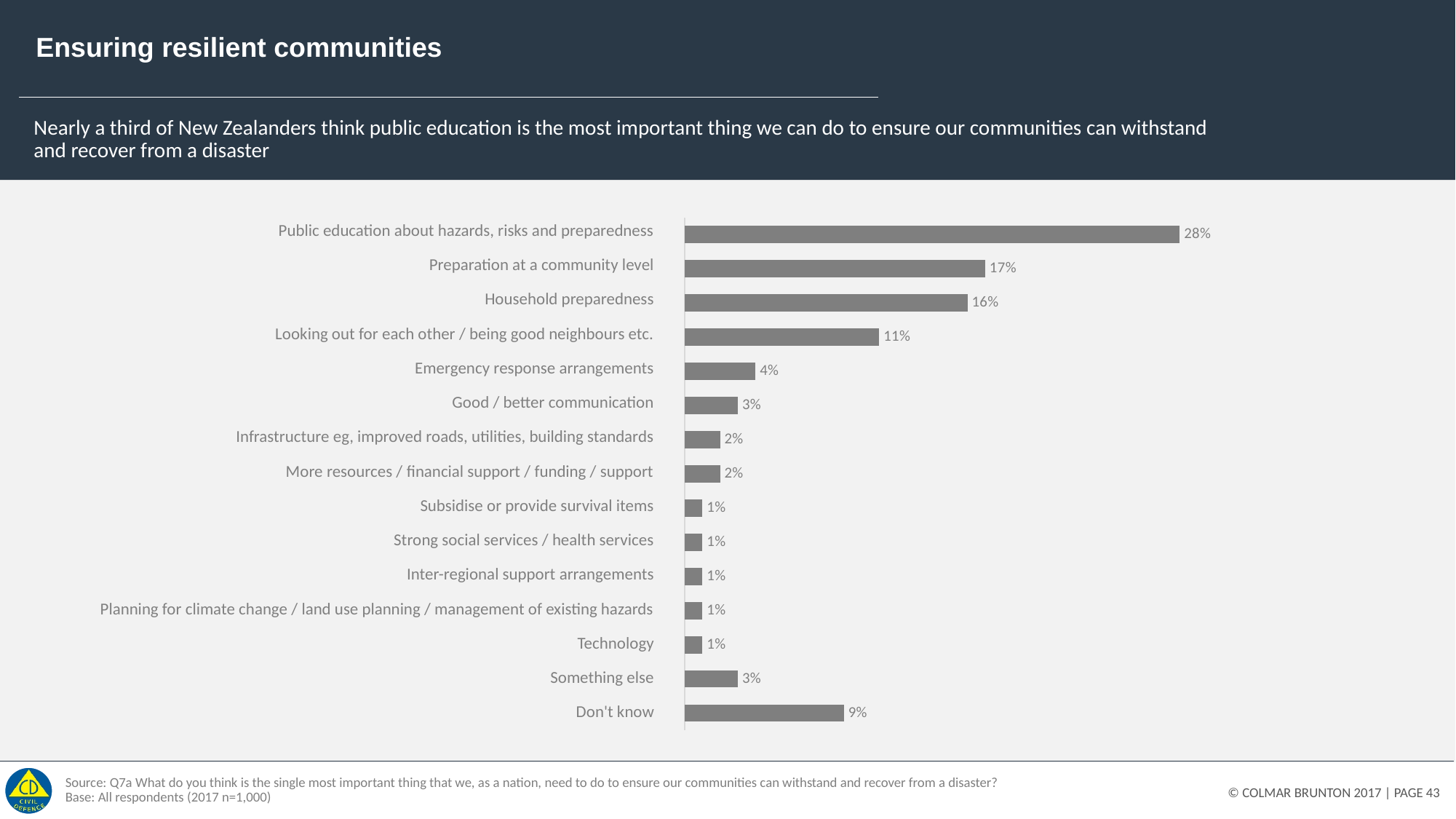
What kind of chart is shown on the slide? Bar chart What is the value for Emergency response arrangements? 4% Which is larger: Good / better communication or Looking out for each other / being good neighbours etc.? Looking out for each other / being good neighbours etc. What is the difference between Preparation at a community level and Household preparedness? 1% What is the value for Something else? 3% What percentage of respondents answered Don't know? 9% What is the value for Household preparedness? 16% What percentage of respondents chose public education about hazards, risks and preparedness? 28% How many categories are shown in the chart? 15 Which category has the highest value? Public education about hazards, risks and preparedness What is the difference between Public education about hazards, risks and preparedness and Looking out for each other / being good neighbours etc.? 17% Which is larger: Don't know or Emergency response arrangements? Don't know